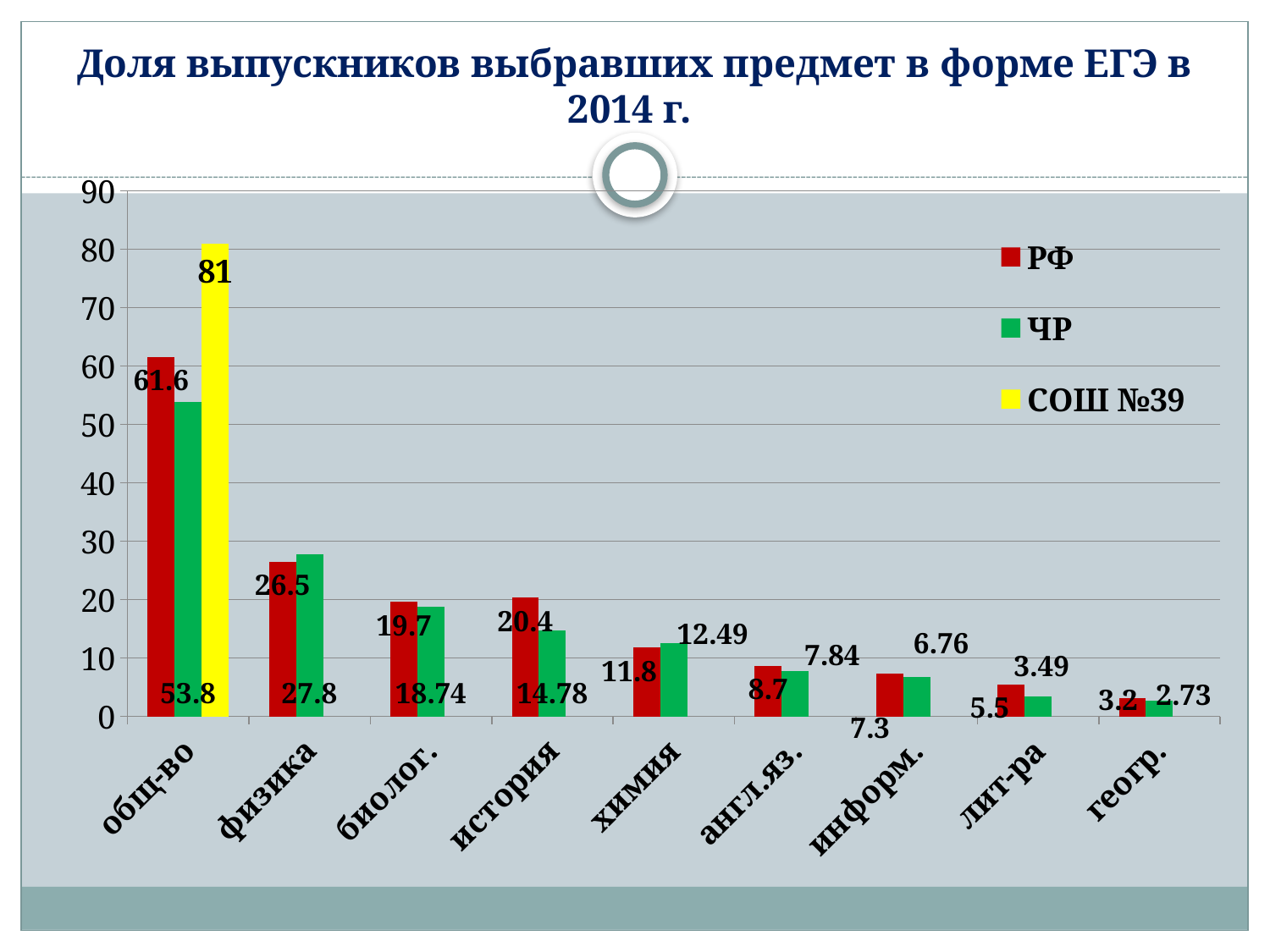
How many subject categories are shown on the x axis? 9 Which category has the highest РФ value? общ-во Which series is shown in yellow in the legend? СОШ №39 Which category has the lowest ЧР value? геогр. What is the difference between the РФ and ЧР values for общ-во? 7.8 How many series does the legend list? 3 Which is larger for физика, the РФ value or the ЧР value? ЧР What type of chart is shown on the slide? bar chart What is the ЧР value for лит-ра? 3.49 What is the value for СОШ №39 in the общ-во category? 81 What is the РФ value for физика? 26.5 What is the ЧР value for история? 14.78